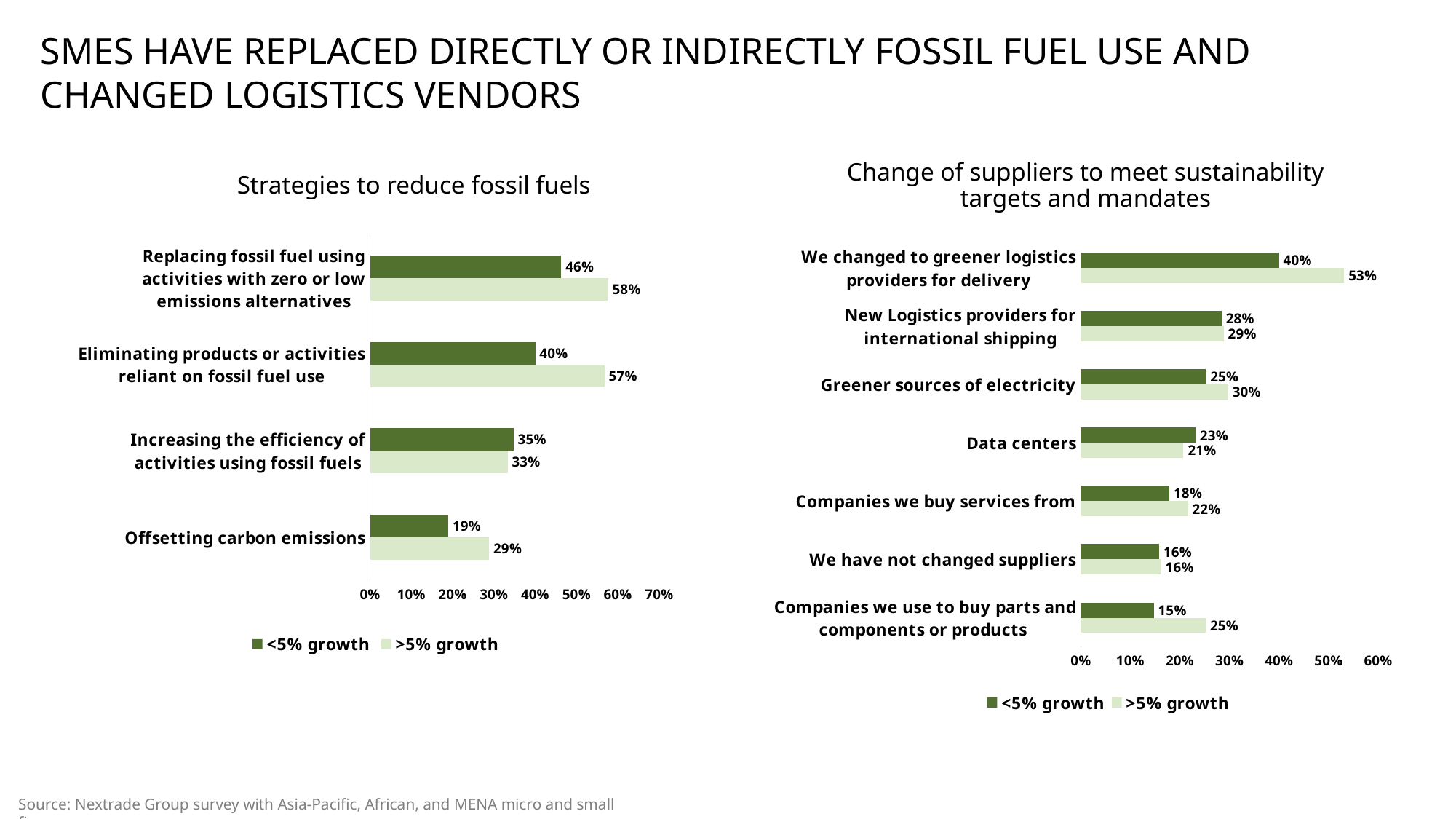
In the 'Strategies to reduce fossil fuels' chart, what is the '<5% growth' value for 'Eliminating products or activities reliant on fossil fuel use'? 40% In the 'Change of suppliers to meet sustainability targets and mandates' chart, what is the '<5% growth' value for 'Data centers'? 23% In the 'Change of suppliers to meet sustainability targets and mandates' chart, which is larger for 'Greener sources of electricity': the '<5% growth' value or the '>5% growth' value? >5% growth In the 'Change of suppliers to meet sustainability targets and mandates' chart, how many categories are shown? 7 In the 'Strategies to reduce fossil fuels' chart, how many categories are shown? 4 In the 'Change of suppliers to meet sustainability targets and mandates' chart, what is the '>5% growth' value for 'We changed to greener logistics providers for delivery'? 53% In the 'Strategies to reduce fossil fuels' chart, what is the difference between the '>5% growth' and '<5% growth' values for 'Replacing fossil fuel using activities with zero or low emissions alternatives'? 12% In the 'Change of suppliers to meet sustainability targets and mandates' chart, what is the difference between the '>5% growth' and '<5% growth' values for 'Companies we use to buy parts and components or products'? 10% How many series does the legend of the 'Strategies to reduce fossil fuels' chart list? 2 In the 'Change of suppliers to meet sustainability targets and mandates' chart, which category has the lowest '<5% growth' value? Companies we use to buy parts and components or products In the 'Strategies to reduce fossil fuels' chart, what is the value for 'Offsetting carbon emissions' in the '>5% growth' series? 29% In the 'Strategies to reduce fossil fuels' chart, which category has the highest '>5% growth' value? Replacing fossil fuel using activities with zero or low emissions alternatives